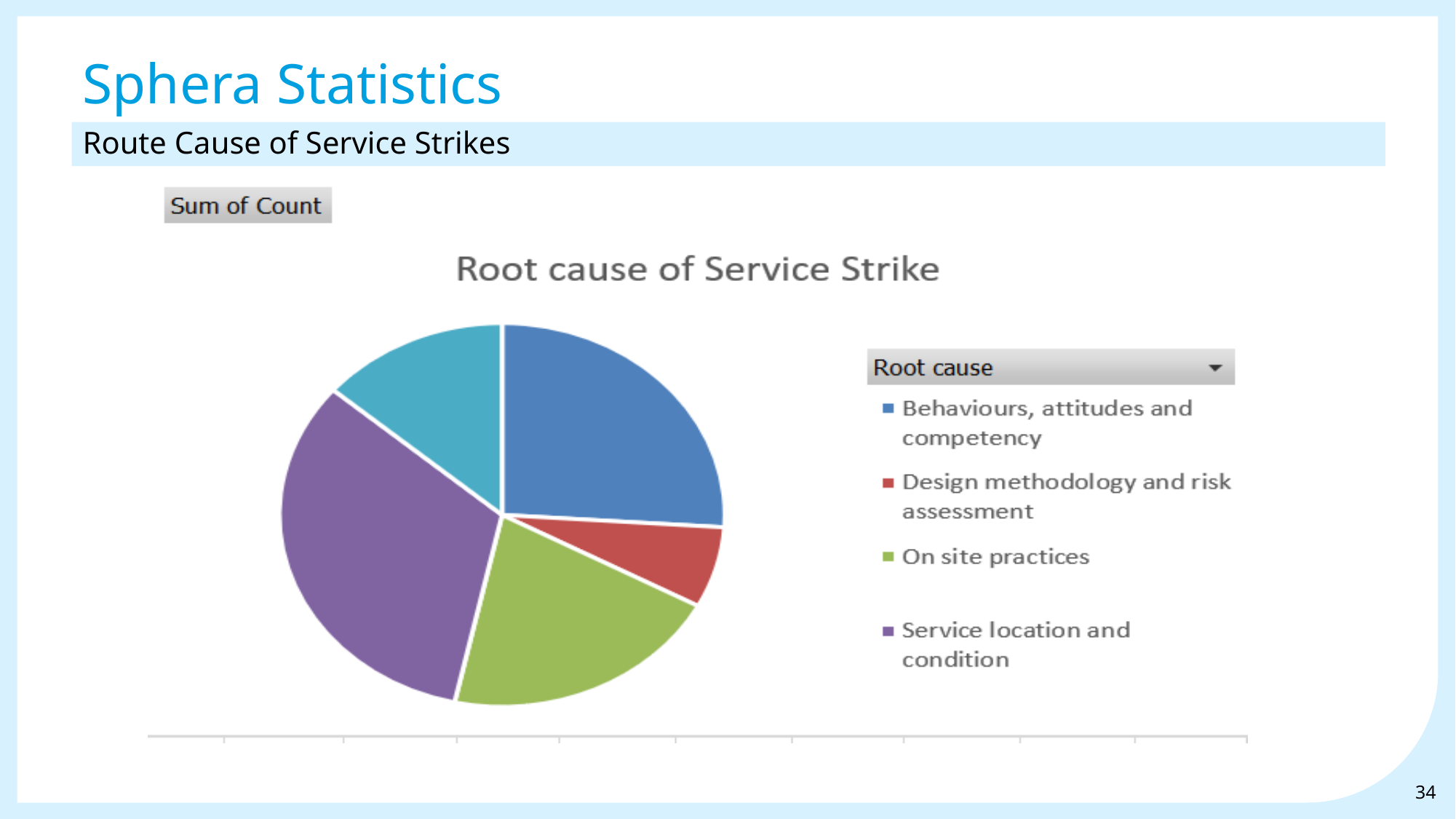
What colour represents On site practices in the pie chart? Green How many slices does the pie chart have? 5 Which slice is larger: Behaviours, attitudes and competency or Design methodology and risk assessment? Behaviours, attitudes and competency Which slice is larger: Service location and condition or On site practices? Service location and condition What is the title of the chart? Root cause of Service Strike Which root cause has the smallest slice of the pie? Design methodology and risk assessment What kind of chart is shown on the slide? Pie chart Which root cause has the largest slice of the pie? Service location and condition Which slice is larger: On site practices or Design methodology and risk assessment? On site practices How many root cause entries are listed in the chart's legend? 4